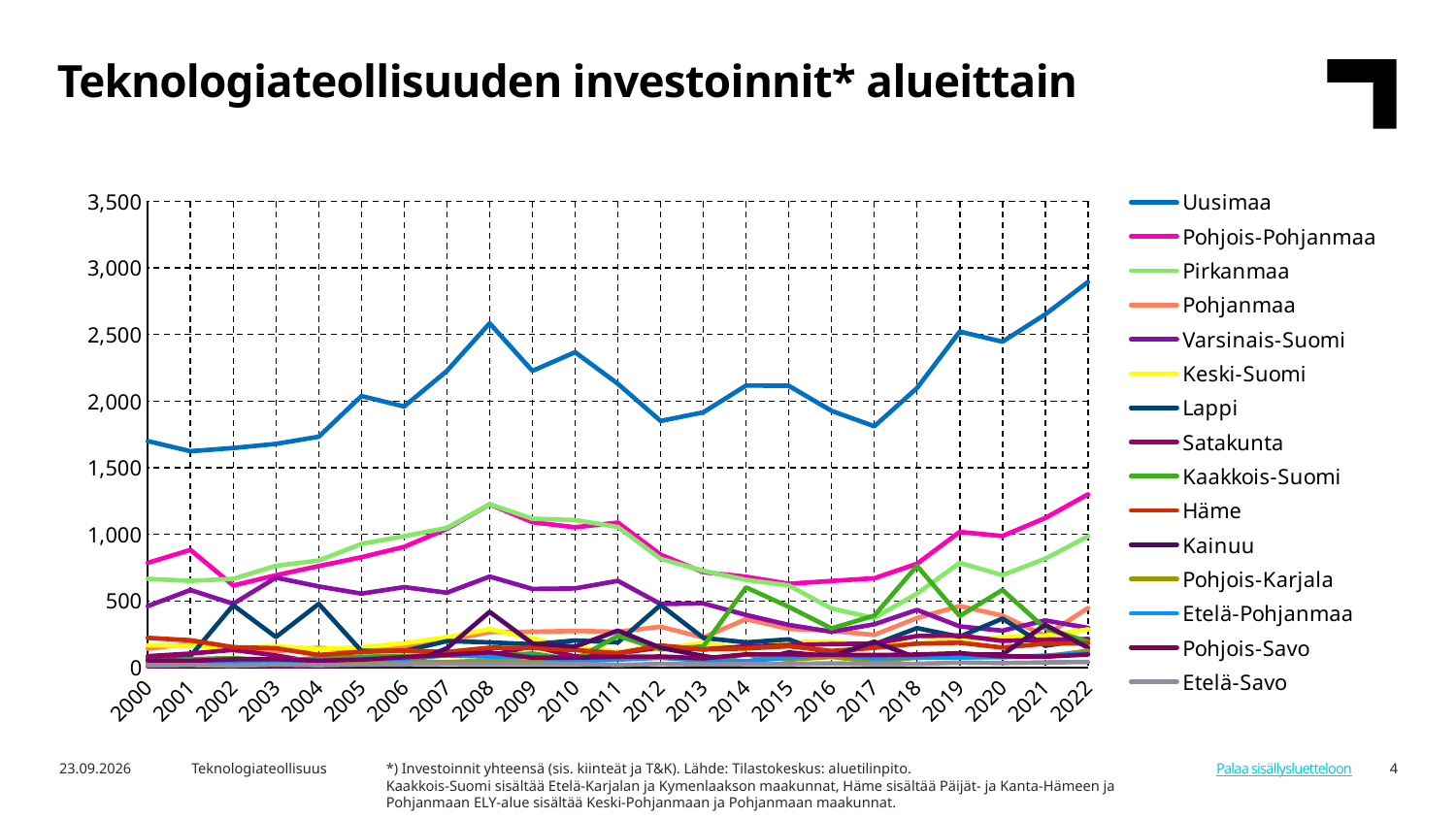
How many years are plotted along the x axis? 23 What is the title of the chart on the slide? Teknologiateollisuuden investoinnit* alueittain Is the value for Pirkanmaa in 2008 greater or less than 1,000? greater In which year does the Uusimaa line reach its highest value? 2022 Which is larger in 2022, the value for Uusimaa or the value for Pohjois-Pohjanmaa? Uusimaa How many series does the legend list? 15 Does the Uusimaa line rise or fall from 2017 to 2022? rise What kind of chart is shown on the slide? line chart Is the value for Pohjois-Pohjanmaa in 2022 greater or less than 1,000? greater Which region has the highest investments across the whole period? Uusimaa Is the value for Uusimaa in 2022 greater or less than 2,500? greater